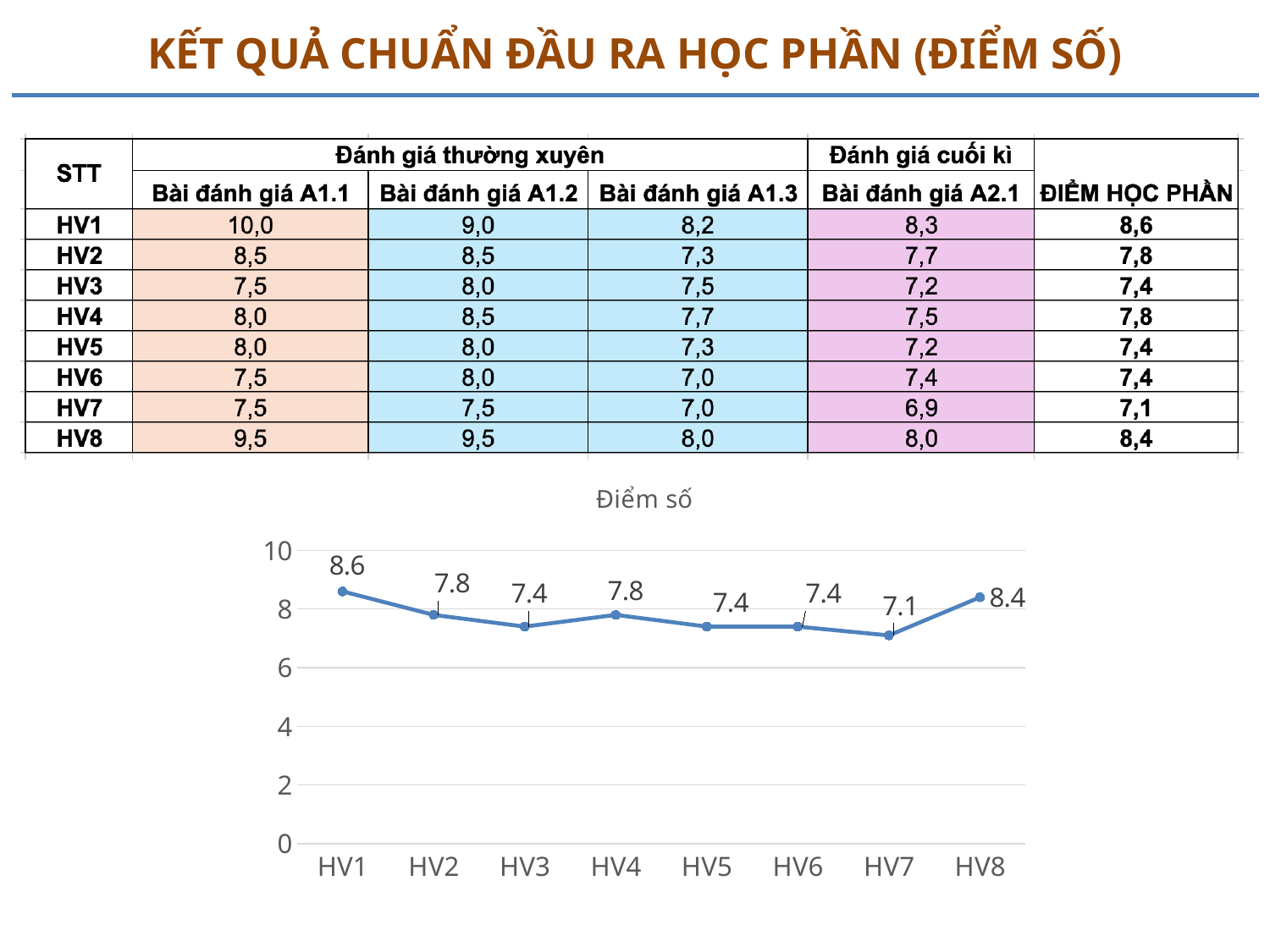
What is the difference between the values for HV1 and HV7? 1.5 Which category has the highest value in the chart? HV1 What is the value for HV8 in the chart? 8.4 What is the value for HV7 in the chart? 7.1 What is the title of the chart? Điểm số Which is larger, the value for HV2 or the value for HV3? HV2 What is the value for HV1 in the chart? 8.6 Does the value rise or fall from HV7 to HV8? rise Which category has the lowest value in the chart? HV7 Is the value for HV5 greater or less than 8? less How many categories are plotted on the x axis of the chart? 8 What type of chart is shown on the slide? line chart